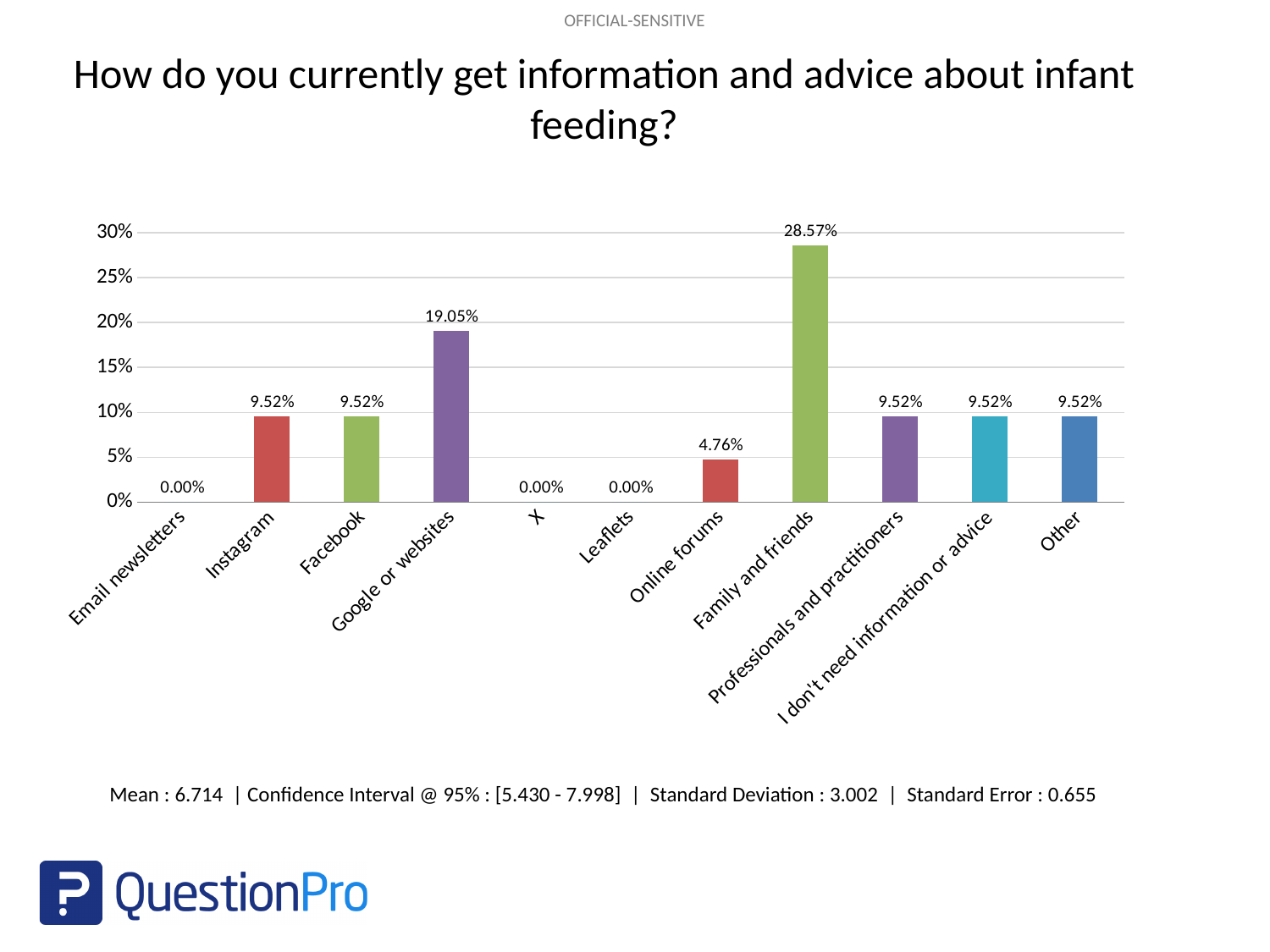
What is the difference between the values for Family and friends and Google or websites? 9.52% What is the value for Leaflets? 0.00% What is the value for Online forums? 4.76% What is the title of the chart? How do you currently get information and advice about infant feeding? Which category has the highest value? Family and friends What is the value for Google or websites? 19.05% Is the value for Family and friends greater or less than 25%? greater What is the value for Family and friends? 28.57% How many categories are shown on the x axis? 11 How many categories have a value of 0.00%? 3 Which is larger, the value for Instagram or the value for Online forums? Instagram What kind of chart is shown on the slide? bar chart